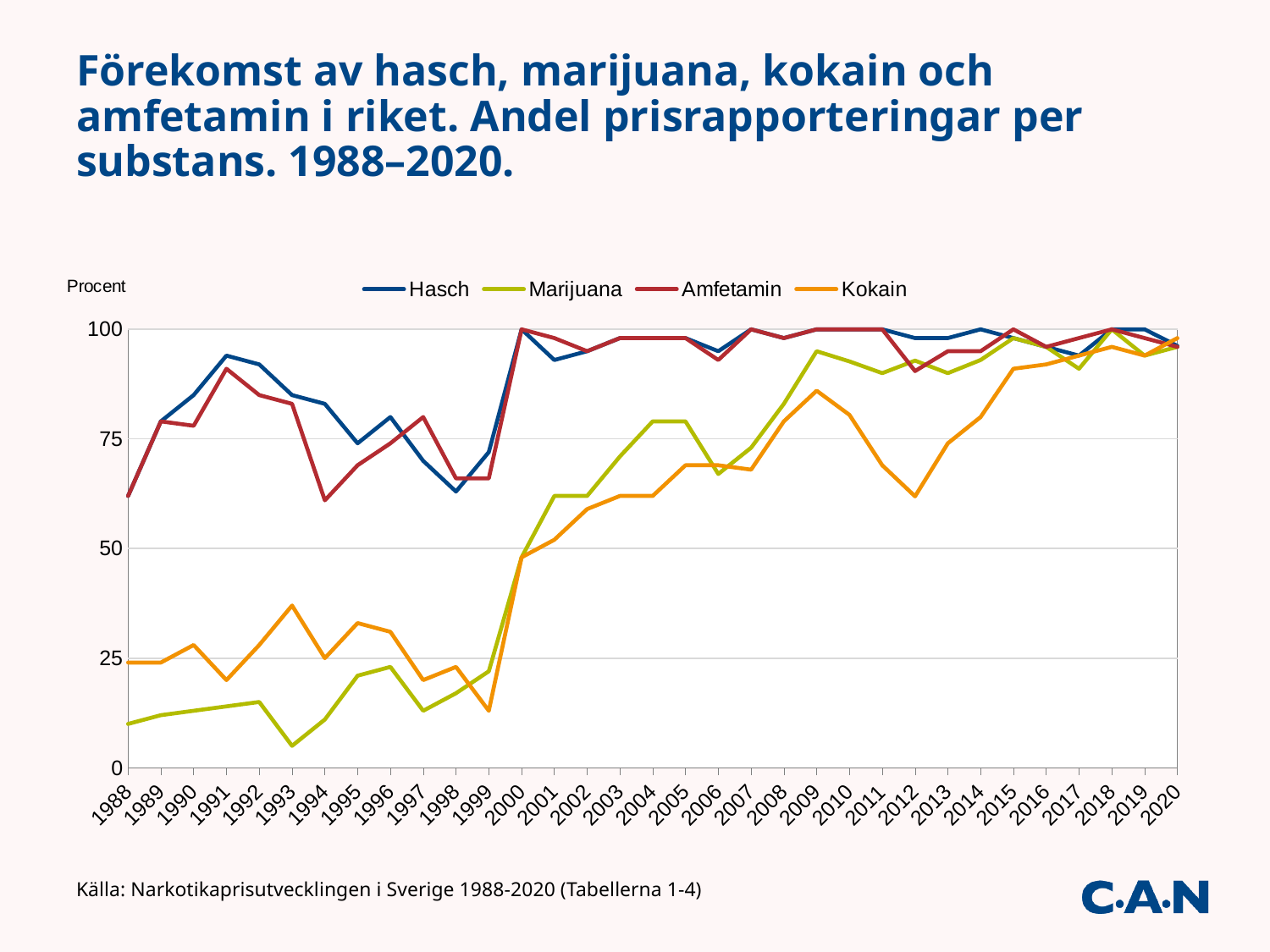
What label is shown on the vertical axis? Procent In 2005, which is larger: the value for Marijuana or the value for Kokain? Marijuana Is the value for Amfetamin in 1994 greater or less than 75? less Is the value for Kokain in 2009 greater or less than 75? greater Is the value for Marijuana in 1988 greater or less than 25? less What kind of chart is shown on the slide? line chart Which series has the lowest value in 1993? Marijuana How many series does the legend list? 4 How many years are plotted along the x axis? 33 Does the Marijuana line overall rise or fall from 1988 to 2020? rise